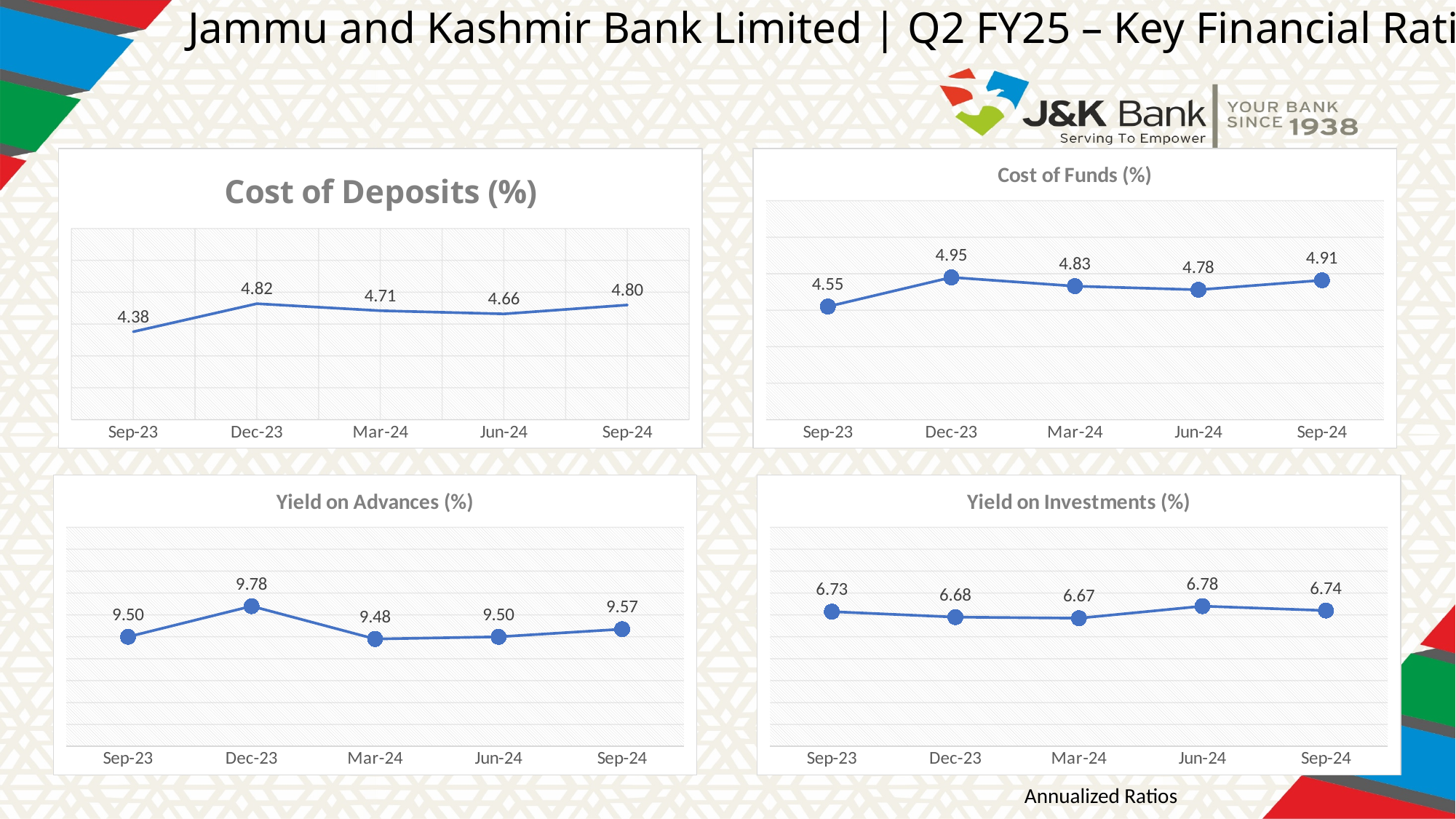
In the Yield on Advances (%) chart, what is the value for Sep-24? 9.57 What type of chart is the Yield on Investments (%) chart? Line chart In the Cost of Funds (%) chart, which period has the highest value? Dec-23 In the Cost of Funds (%) chart, what is the value for Jun-24? 4.78 In the Yield on Investments (%) chart, what is the value for Mar-24? 6.67 In the Cost of Deposits (%) chart, what is the value for Dec-23? 4.82 In the Yield on Advances (%) chart, what is the difference between the Dec-23 and Mar-24 values? 0.30 In the Yield on Investments (%) chart, is the value for Jun-24 larger or smaller than the value for Sep-24? larger In the Cost of Deposits (%) chart, which period has the lowest value? Sep-23 In the Yield on Advances (%) chart, which period has the highest value? Dec-23 In the Cost of Deposits (%) chart, what is the difference between the Sep-24 and Sep-23 values? 0.42 In the Cost of Funds (%) chart, how many data points are plotted? 5